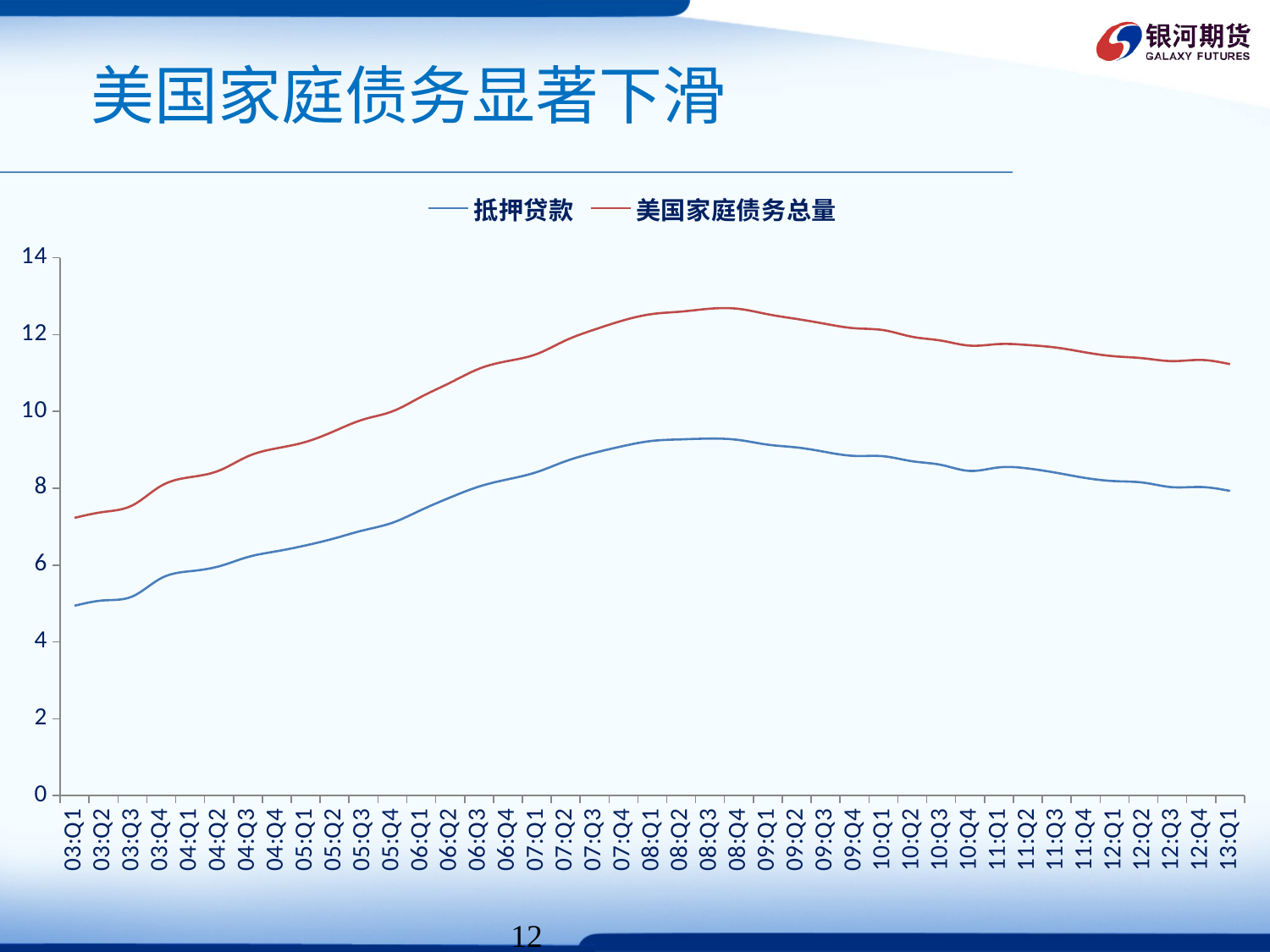
How many quarters are shown on the x axis, from 03:Q1 to 13:Q1? 41 Is the value for 美国家庭债务总量 at 13:Q1 greater or less than 10? greater At 08:Q3, which series has the larger value, 抵押贷款 or 美国家庭债务总量? 美国家庭债务总量 What kind of chart is shown on the slide? line chart Is the value for 美国家庭债务总量 at 08:Q3 greater or less than 12? greater Is the value for 抵押贷款 at 08:Q3 greater or less than 10? less What is the title of the slide? 美国家庭债务显著下滑 How many series does the legend list? 2 Between 09:Q1 and 13:Q1, does the value for 美国家庭债务总量 rise or fall? fall What are the two series named in the legend? 抵押贷款 and 美国家庭债务总量